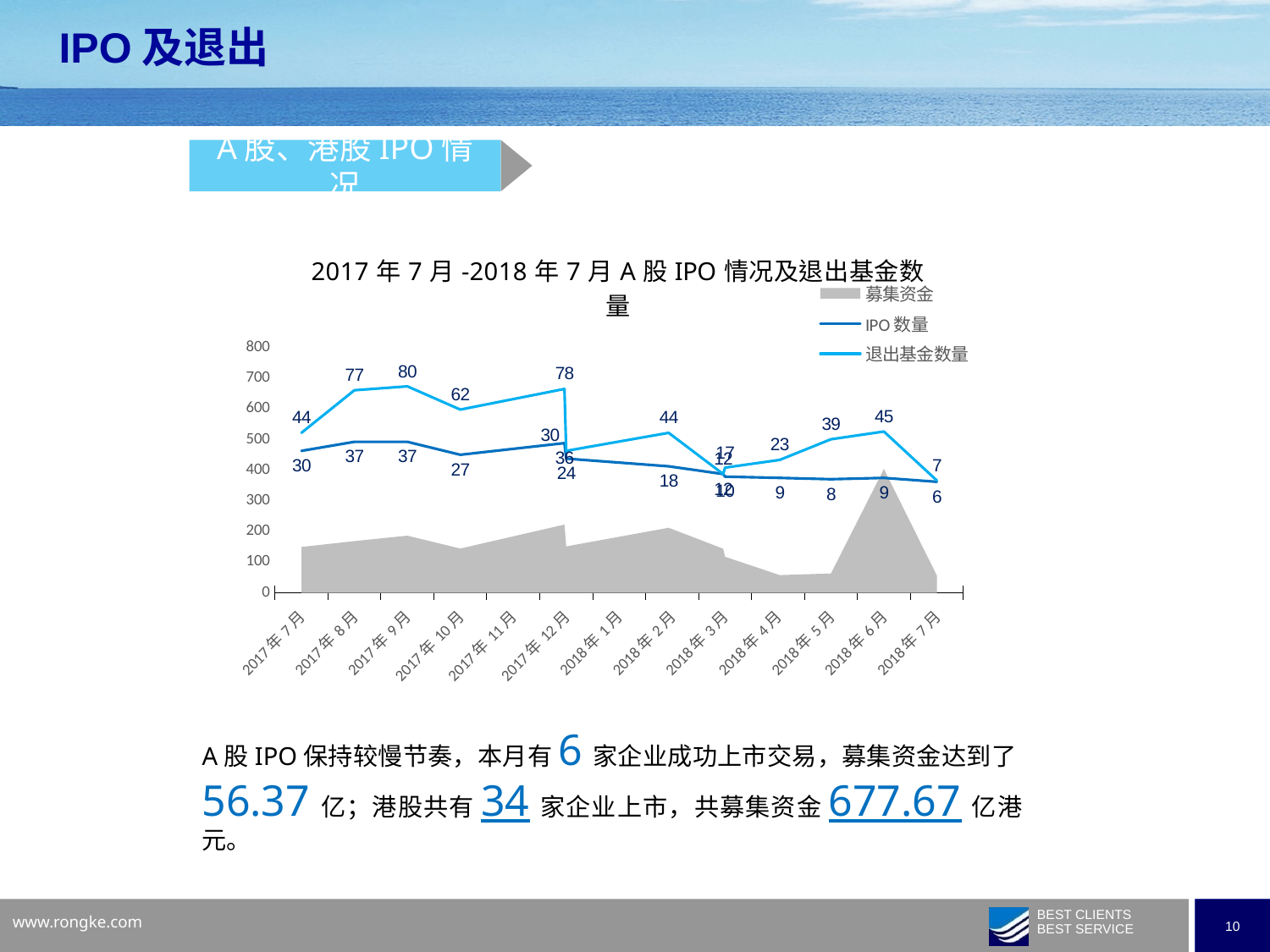
Which is larger, IPO 数量 in 2017年8月 or in 2018年2月? 2017年8月 Which series is drawn as a gray shaded area? 募集资金 How many months are shown on the x axis? 13 What is the 退出基金数量 value for 2017年9月? 80 Is the 募集资金 value for 2018年6月 greater or less than 300? greater What is the IPO 数量 value for 2017年7月? 30 What is the difference between 退出基金数量 in 2017年8月 and 2017年7月? 33 What is the 退出基金数量 value for 2018年6月? 45 In which month is 退出基金数量 lowest? 2018年7月 What is the IPO 数量 value for 2018年7月? 6 In which month is 退出基金数量 highest? 2017年9月 How many series does the legend list? 3